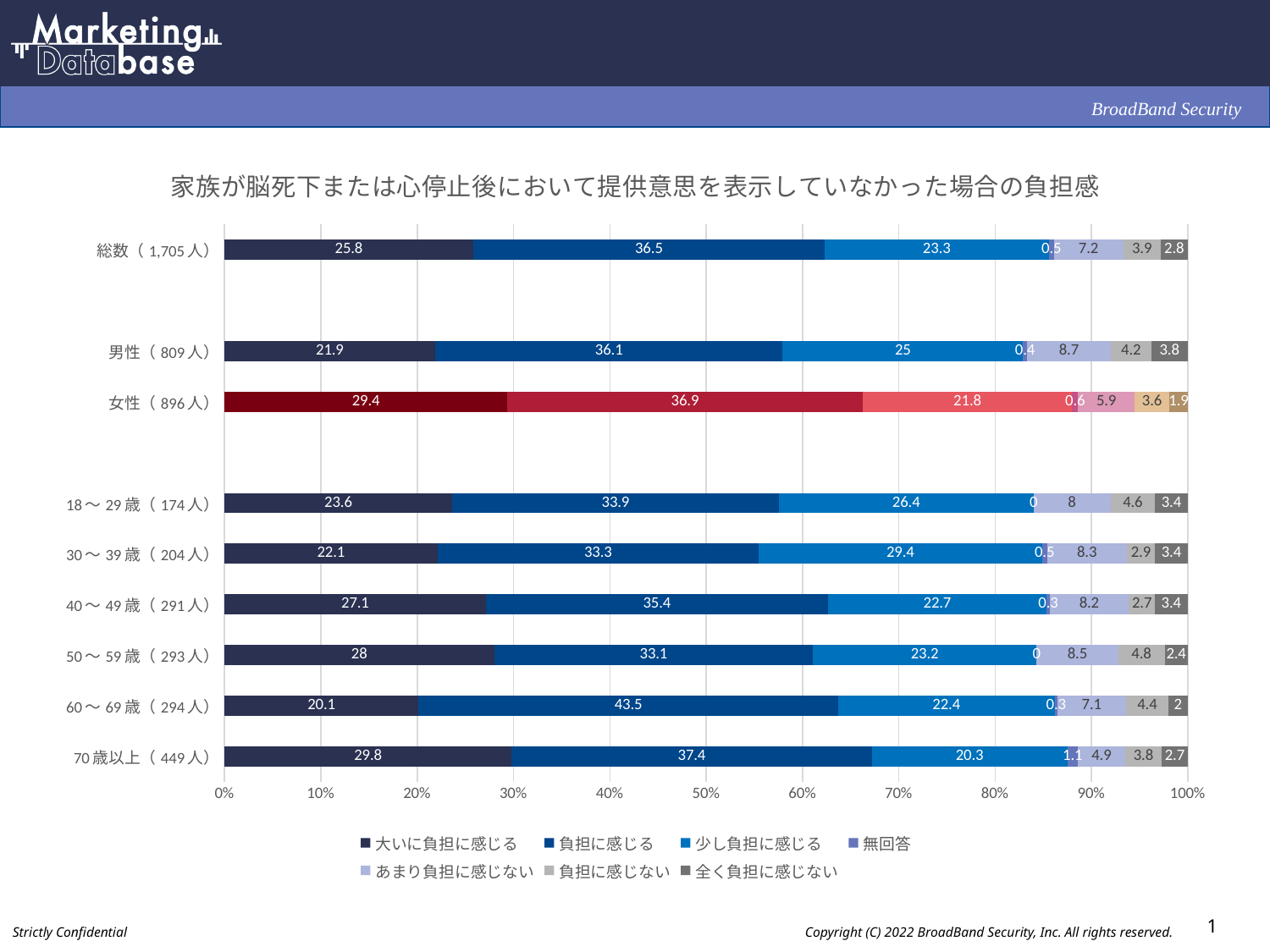
What is the value of あまり負担に感じない for 男性 (809人)? 8.7 How many series does the legend list? 7 Which category has the lowest value for 大いに負担に感じる? 60～69歳 (294人) How many categories are shown on the chart? 9 What is the value of 負担に感じる for 60～69歳 (294人)? 43.5 What is the title of the chart? 家族が脳死下または心停止後において提供意思を表示していなかった場合の負担感 Which category has the highest value for 大いに負担に感じる? 70歳以上 (449人) Which is larger, the 少し負担に感じる value for 30～39歳 (204人) or for 40～49歳 (291人)? 30～39歳 (204人) What is the difference between the 大いに負担に感じる values for 女性 (896人) and 男性 (809人)? 7.5 What kind of chart is shown on the slide? Stacked bar chart What is the value of 大いに負担に感じる for 総数 (1,705人)? 25.8 What is the value of 無回答 for 70歳以上 (449人)? 1.1